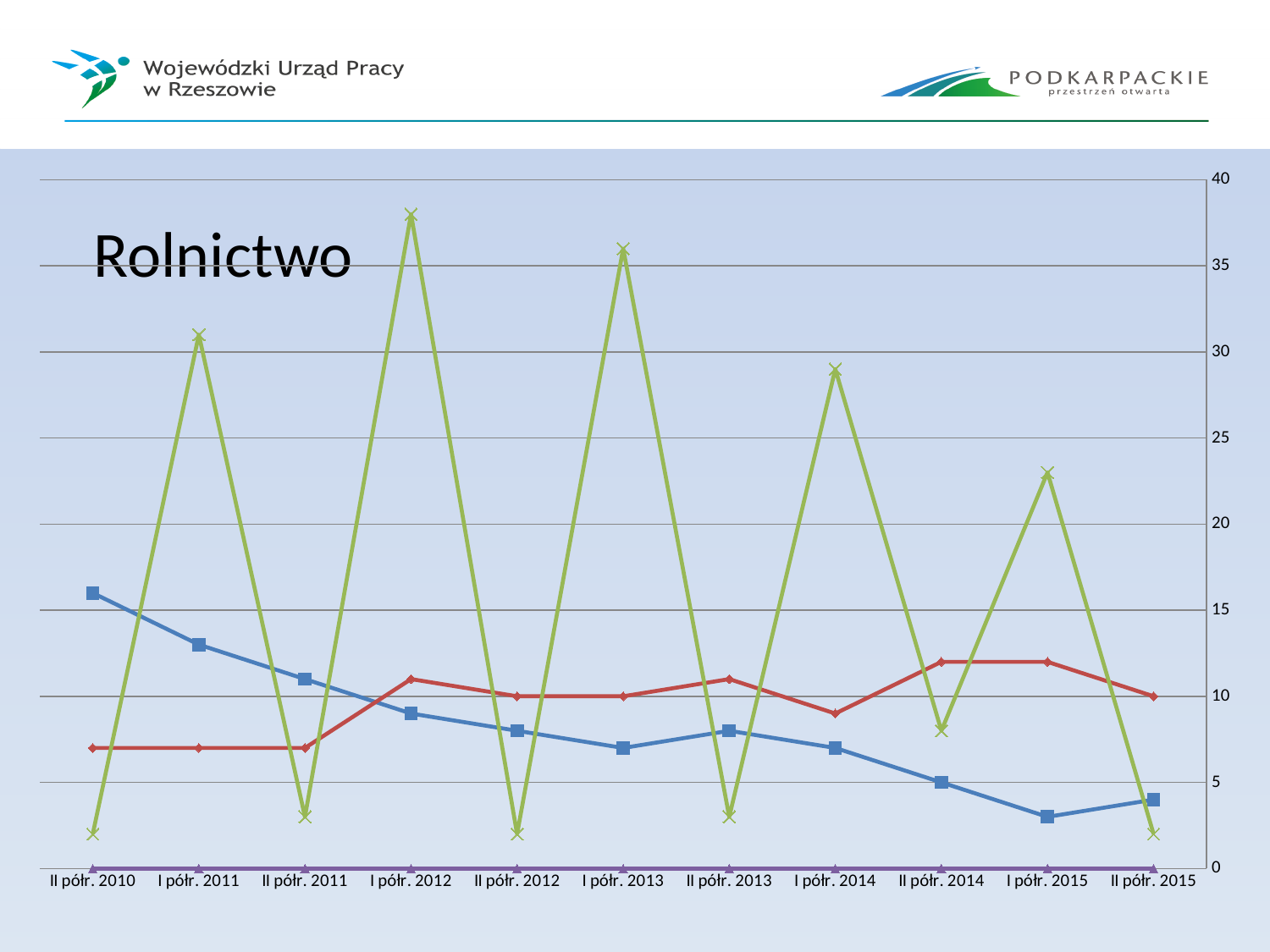
What kind of chart is shown on the slide? line chart Which period has the highest value on the green line? I półr. 2012 How many time periods are shown along the x axis? 11 At I półr. 2014, which line has the larger value, the green line or the red line? the green line Is the value of the green line at II półr. 2012 greater or less than 5? less Is the value of the blue line at II półr. 2010 greater or less than 15? greater At II półr. 2010, which line has the larger value, the blue line or the red line? the blue line Is the value of the blue line at I półr. 2015 greater or less than 5? less Does the blue line generally rise or fall from II półr. 2010 to II półr. 2015? fall Which period has the lowest value on the blue line? I półr. 2015 What is the title of the chart? Rolnictwo